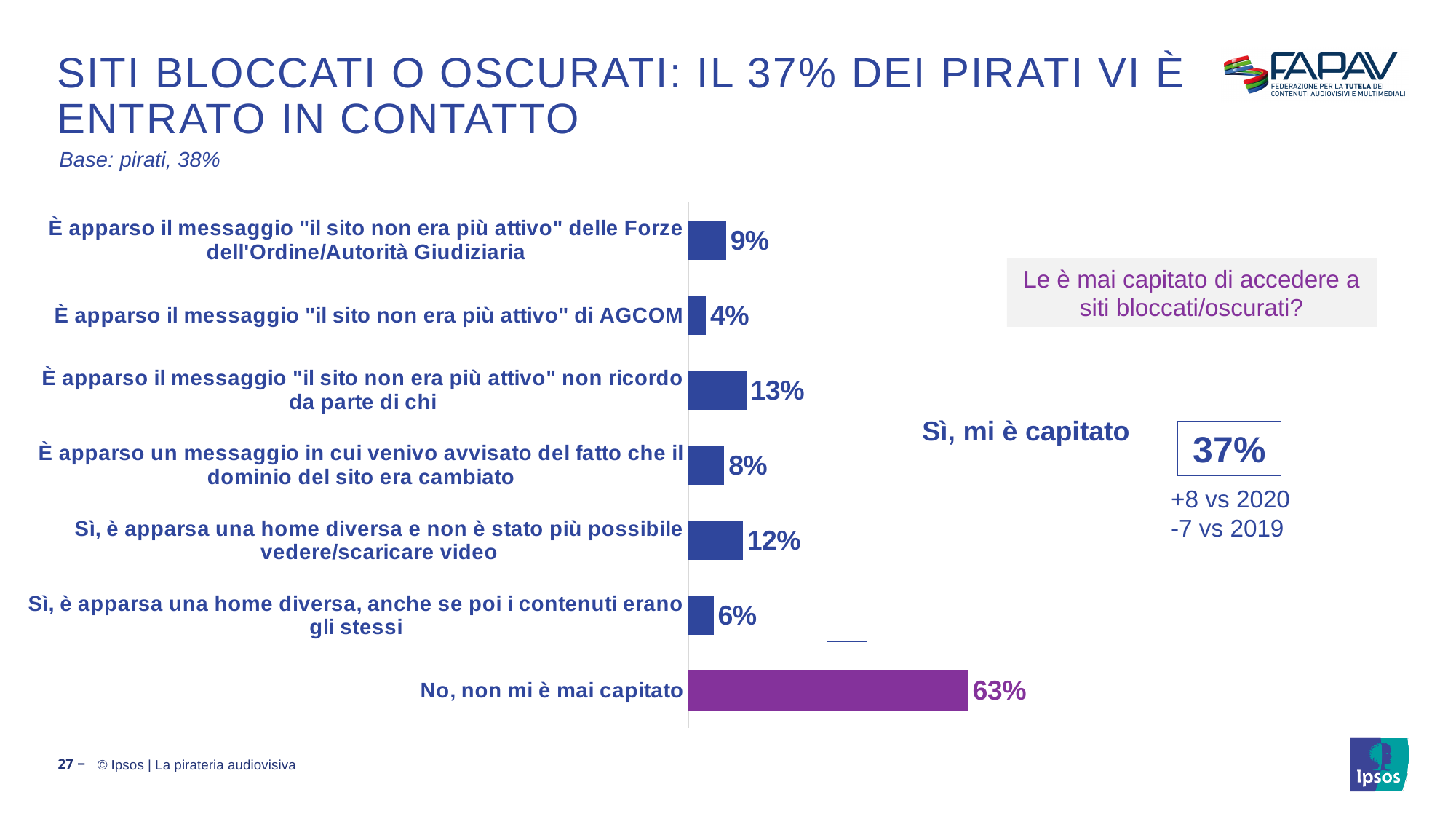
What is the difference between the value for "No, non mi è mai capitato" and the value for "È apparso il messaggio "il sito non era più attivo" non ricordo da parte di chi"? 50% What is the value for "Sì, è apparsa una home diversa e non è stato più possibile vedere/scaricare video"? 12% What is the value for "È apparso il messaggio "il sito non era più attivo" non ricordo da parte di chi"? 13% Which category has the highest value? No, non mi è mai capitato What is the value for "È apparso il messaggio "il sito non era più attivo" di AGCOM"? 4% What kind of chart is shown on the slide? Bar chart Which category has the lowest value? È apparso il messaggio "il sito non era più attivo" di AGCOM How many categories are shown in the chart? 7 What colour is the bar for "No, non mi è mai capitato"? Purple What is the value for "No, non mi è mai capitato"? 63% Which is larger: the value for "È apparso il messaggio "il sito non era più attivo" delle Forze dell'Ordine/Autorità Giudiziaria" or the value for "Sì, è apparsa una home diversa, anche se poi i contenuti erano gli stessi"? È apparso il messaggio "il sito non era più attivo" delle Forze dell'Ordine/Autorità Giudiziaria